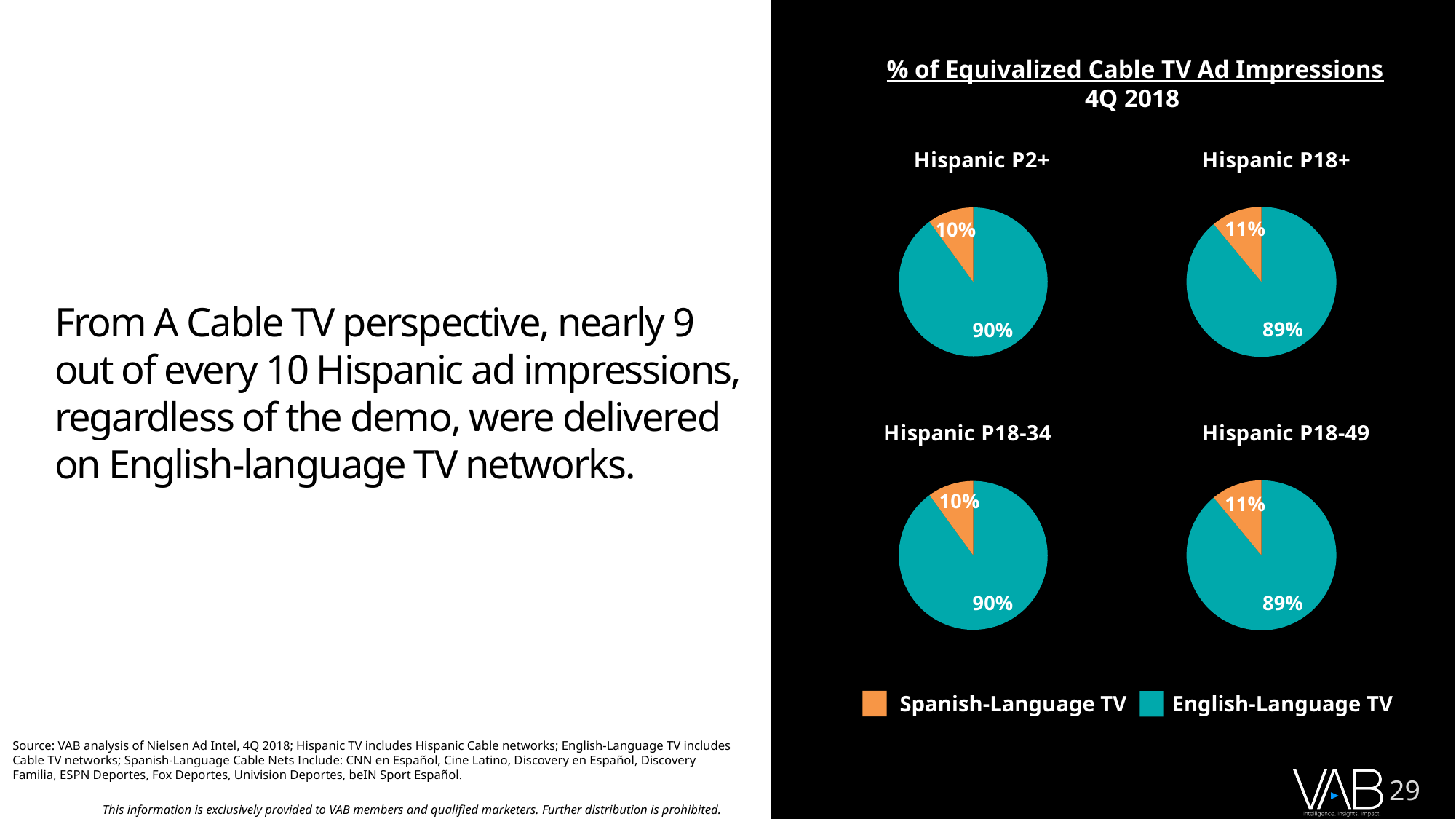
In the Hispanic P2+ pie chart, what share of equivalized cable TV ad impressions went to English-Language TV? 90% In the Hispanic P18-34 pie chart, what is the Spanish-Language TV share? 10% In the Hispanic P18+ pie chart, what is the difference between the English-Language TV share and the Spanish-Language TV share? 78 percentage points In the Hispanic P18+ pie chart, what share of ad impressions went to Spanish-Language TV? 11% Which colour represents Spanish-Language TV in the pie charts? Orange What kind of charts are shown on the slide? Pie charts In the Hispanic P2+ pie chart, what is the difference between the English-Language TV share and the Spanish-Language TV share? 80 percentage points In the Hispanic P18-49 pie chart, which slice is larger, Spanish-Language TV or English-Language TV? English-Language TV How many pie charts are shown on the slide? 4 In the Hispanic P18-49 pie chart, what is the English-Language TV share? 89% How many series does the legend list? 2 What is the title above the pie charts? % of Equivalized Cable TV Ad Impressions 4Q 2018